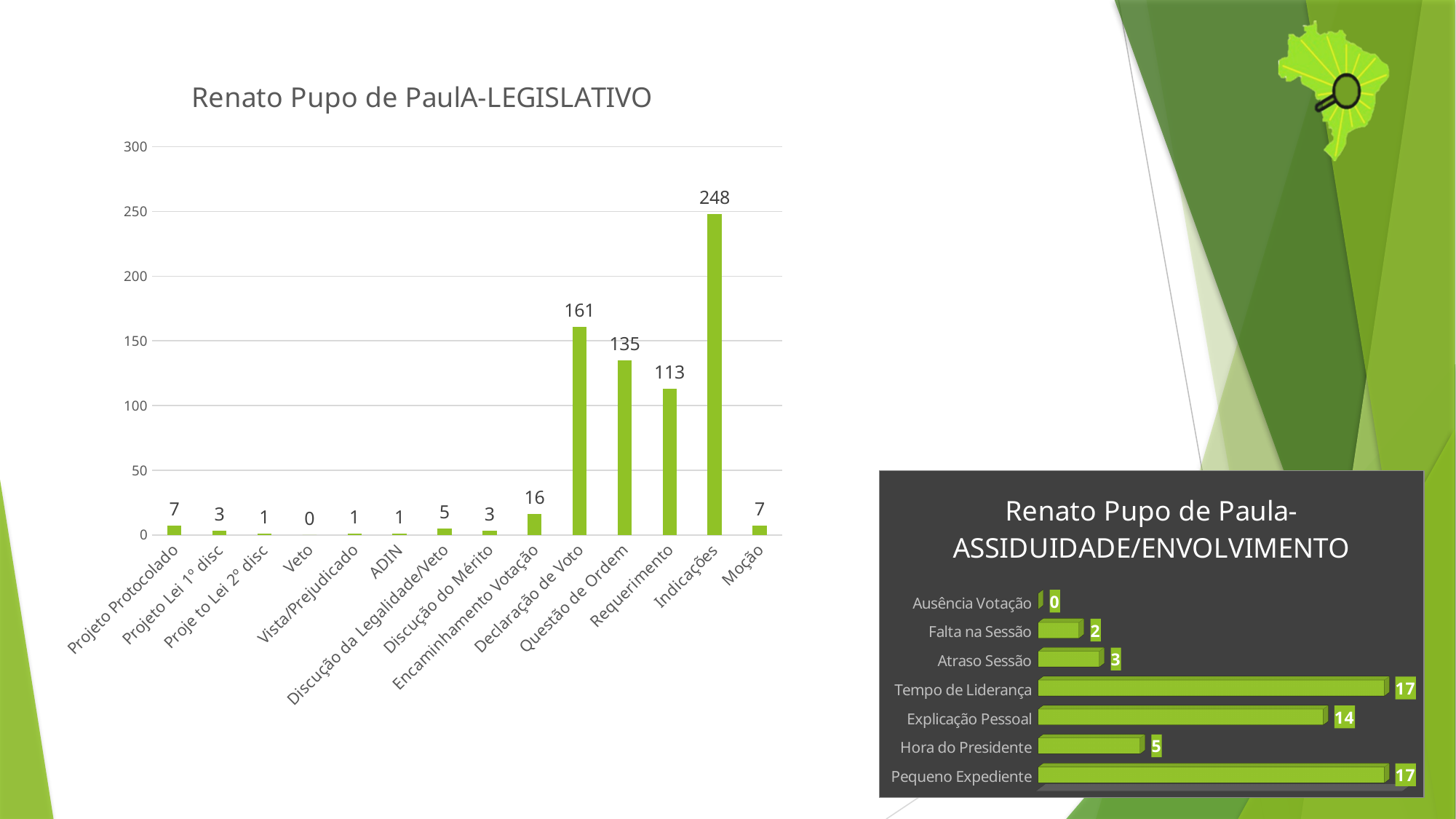
In the LEGISLATIVO chart, which category has the highest value? Indicações How many categories are shown in the ASSIDUIDADE/ENVOLVIMENTO chart? 7 In the ASSIDUIDADE/ENVOLVIMENTO chart, which category has the lowest value? Ausência Votação In the LEGISLATIVO chart, what is the value for Indicações? 248 How many categories are shown in the LEGISLATIVO chart? 14 In the ASSIDUIDADE/ENVOLVIMENTO chart, what is the value for Explicação Pessoal? 14 In the ASSIDUIDADE/ENVOLVIMENTO chart, what is the difference between Tempo de Liderança and Hora do Presidente? 12 In the LEGISLATIVO chart, what is the difference between Declaração de Voto and Requerimento? 48 What kind of chart is the LEGISLATIVO chart? Bar chart In the LEGISLATIVO chart, what is the value for Questão de Ordem? 135 In the LEGISLATIVO chart, which category has the lowest value? Veto In the LEGISLATIVO chart, which is larger: Encaminhamento Votação or Moção? Encaminhamento Votação